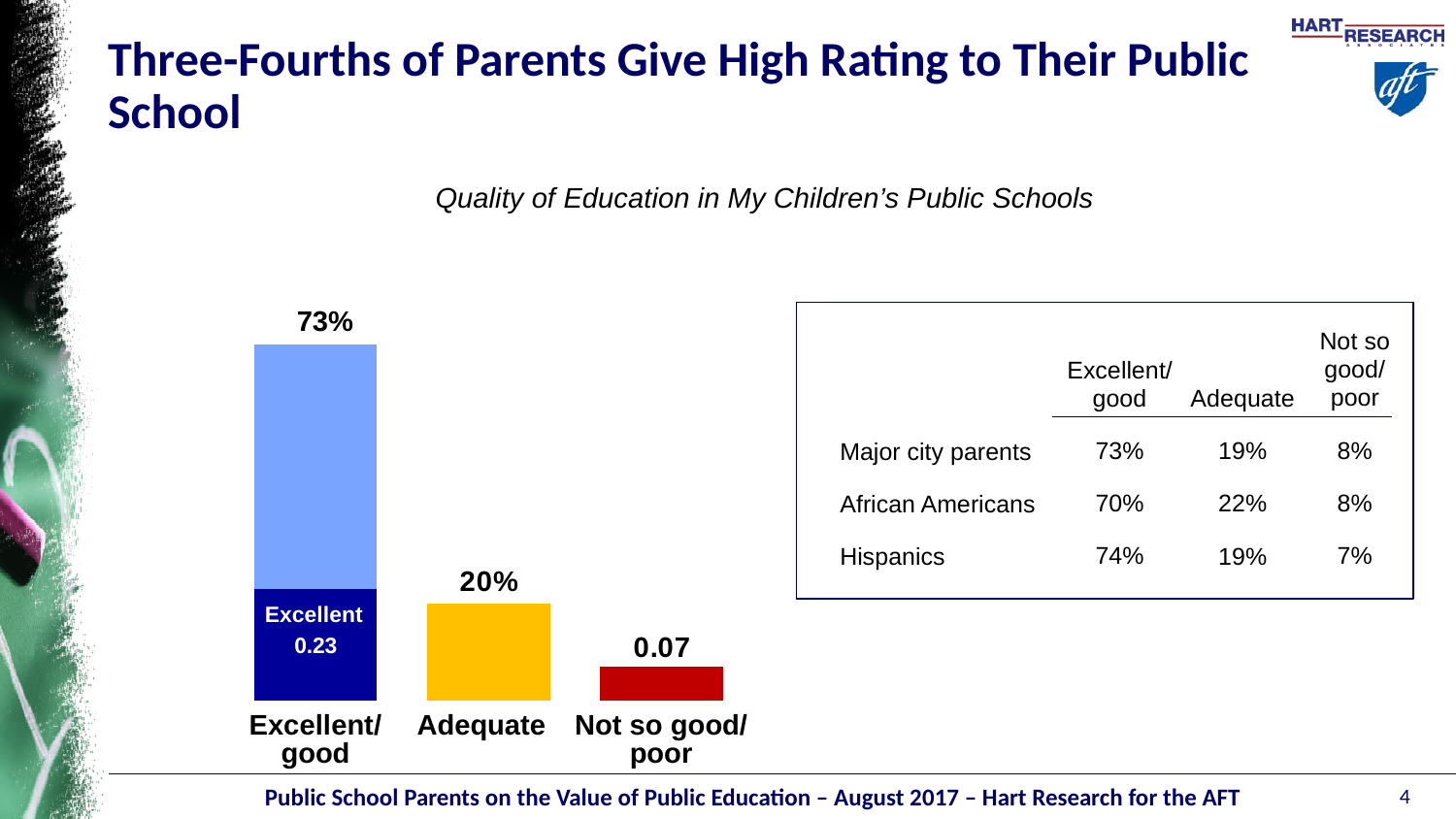
What kind of chart is shown on the slide? Bar chart Which category has the lowest value? Not so good/poor Which is larger, the value for Adequate or the value for Not so good/poor? Adequate What is the title shown above the chart? Quality of Education in My Children's Public Schools Which category has the highest value? Excellent/good What is the difference between the Excellent/good value and the Adequate value? 53% What value is printed above the Not so good/poor bar? 0.07 Do the values rise or fall from left to right across the categories? Fall What is the value shown for the Adequate bar? 20% What is the value shown for the Excellent/good bar? 73% How many categories are shown on the x axis of the chart? 3 What value is printed inside the Excellent segment of the Excellent/good bar? 0.23